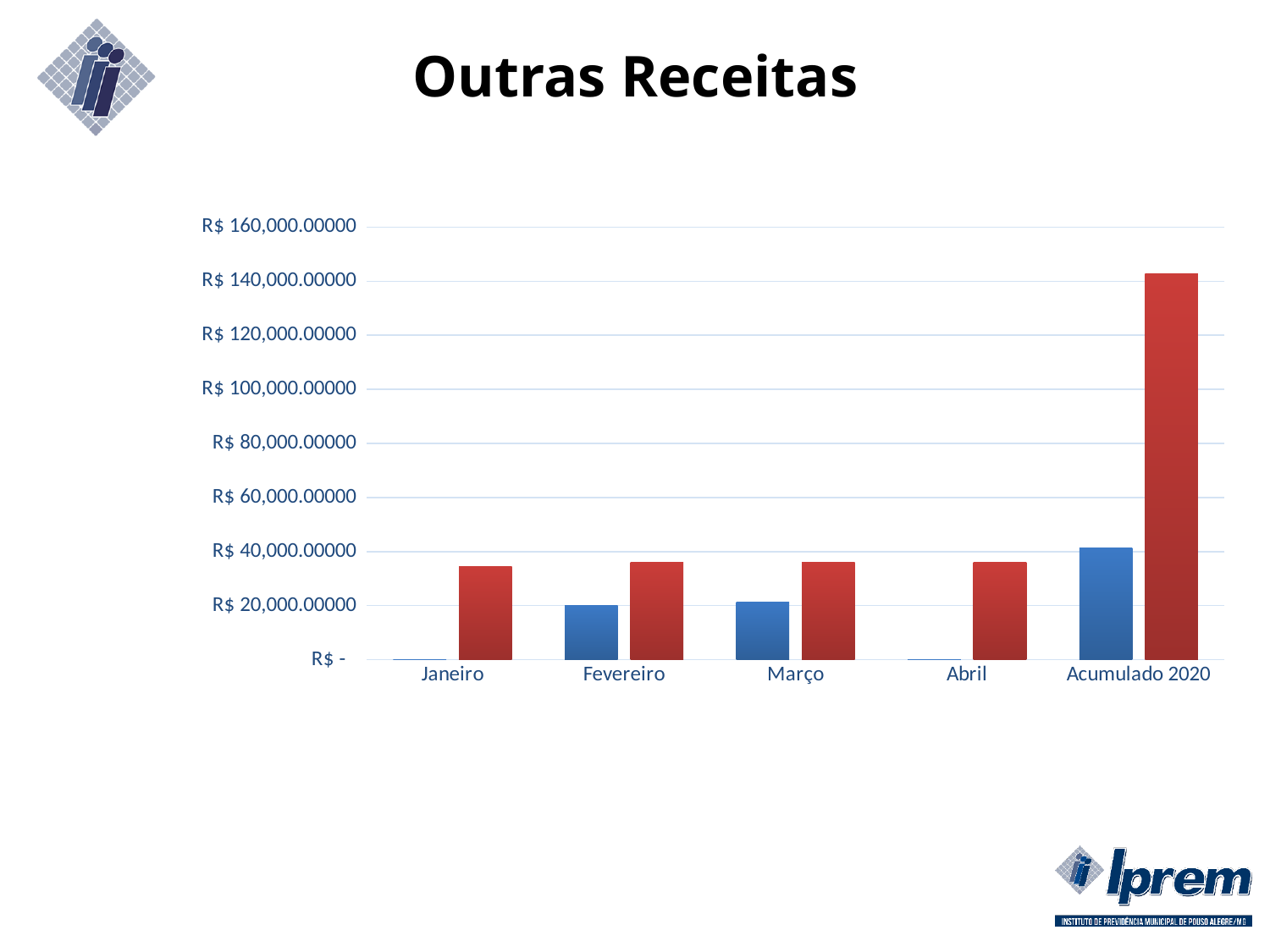
Is the red bar for Acumulado 2020 greater or less than R$ 120,000.00000? greater Is the red bar for Janeiro greater or less than R$ 40,000.00000? less How many categories are shown on the x axis of the chart? 5 For Fevereiro, which bar is taller, the blue one or the red one? the red one What is the title of the slide with the chart? Outras Receitas Is the blue bar for Fevereiro greater or less than R$ 40,000.00000? less Which category has the tallest blue bar? Acumulado 2020 How many bars are plotted for each category in the chart? 2 What kind of chart is shown on the slide? bar chart Which blue bar is taller, Março or Acumulado 2020? Acumulado 2020 Which category has the tallest red bar? Acumulado 2020